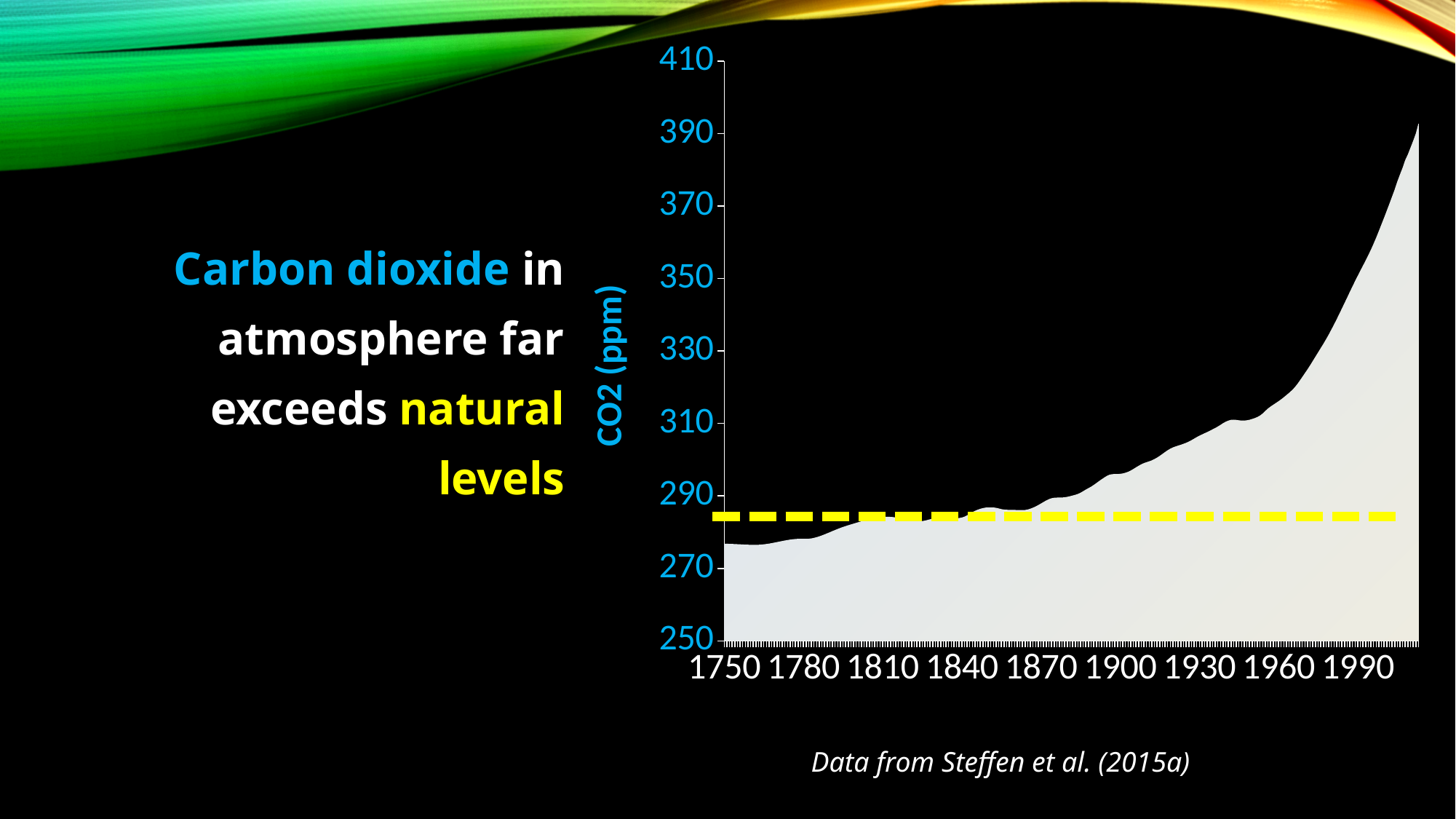
Is the CO2 value at the right end of the chart greater or less than 370? greater Is the CO2 value in 1900 greater or less than 310? less What kind of chart is shown on the slide? area chart Is the CO2 value in 1960 greater or less than 330? less Which year has the larger CO2 value, 1750 or 1990? 1990 What colour is the dashed horizontal line on the chart? yellow How many year labels are shown on the x axis? 9 Do the CO2 values generally rise or fall from 1750 to the right end of the chart? rise What is the label of the vertical axis? CO2 (ppm)